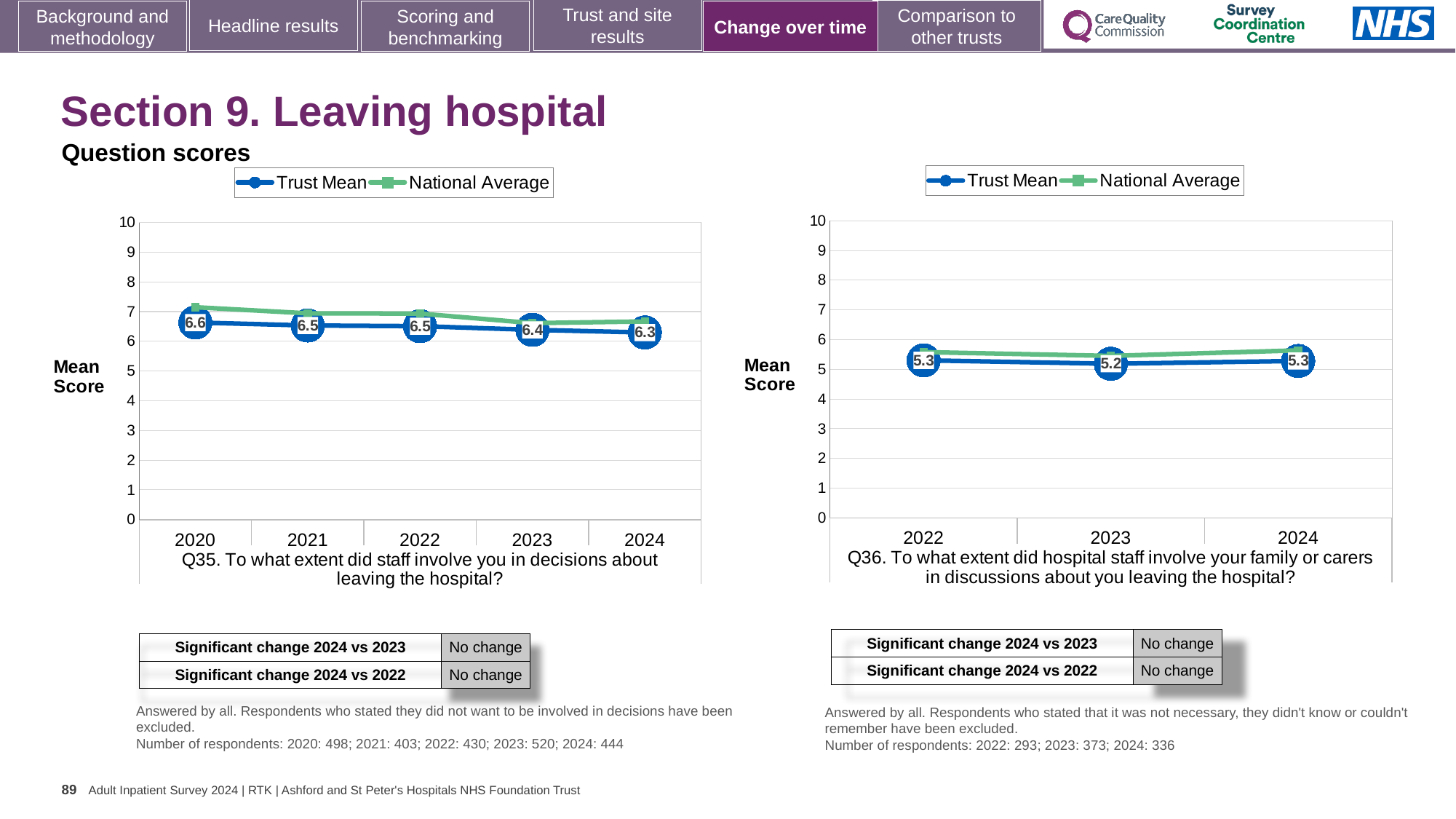
In the Q36 chart on the right, which year has the lowest Trust Mean score? 2023 What kind of chart is the Q35 chart on the left? Line chart In the Q35 chart on the left, which year has the lowest Trust Mean score? 2024 In the Q35 chart on the left, what is the Trust Mean score for 2024? 6.3 In the Q35 chart on the left, is the Trust Mean score higher in 2021 or in 2024? 2021 How many series does the legend of the Q35 chart on the left list? 2 In the Q35 chart on the left, what is the Trust Mean score for 2020? 6.6 In the Q35 chart on the left, what is the difference between the Trust Mean scores for 2020 and 2024? 0.3 In the Q35 chart on the left, which year has the highest Trust Mean score? 2020 In the Q36 chart on the right, is the National Average value for 2024 greater or less than 6? less In the Q36 chart on the right, what is the Trust Mean score for 2023? 5.2 How many years are plotted on the x axis of the Q36 chart on the right? 3